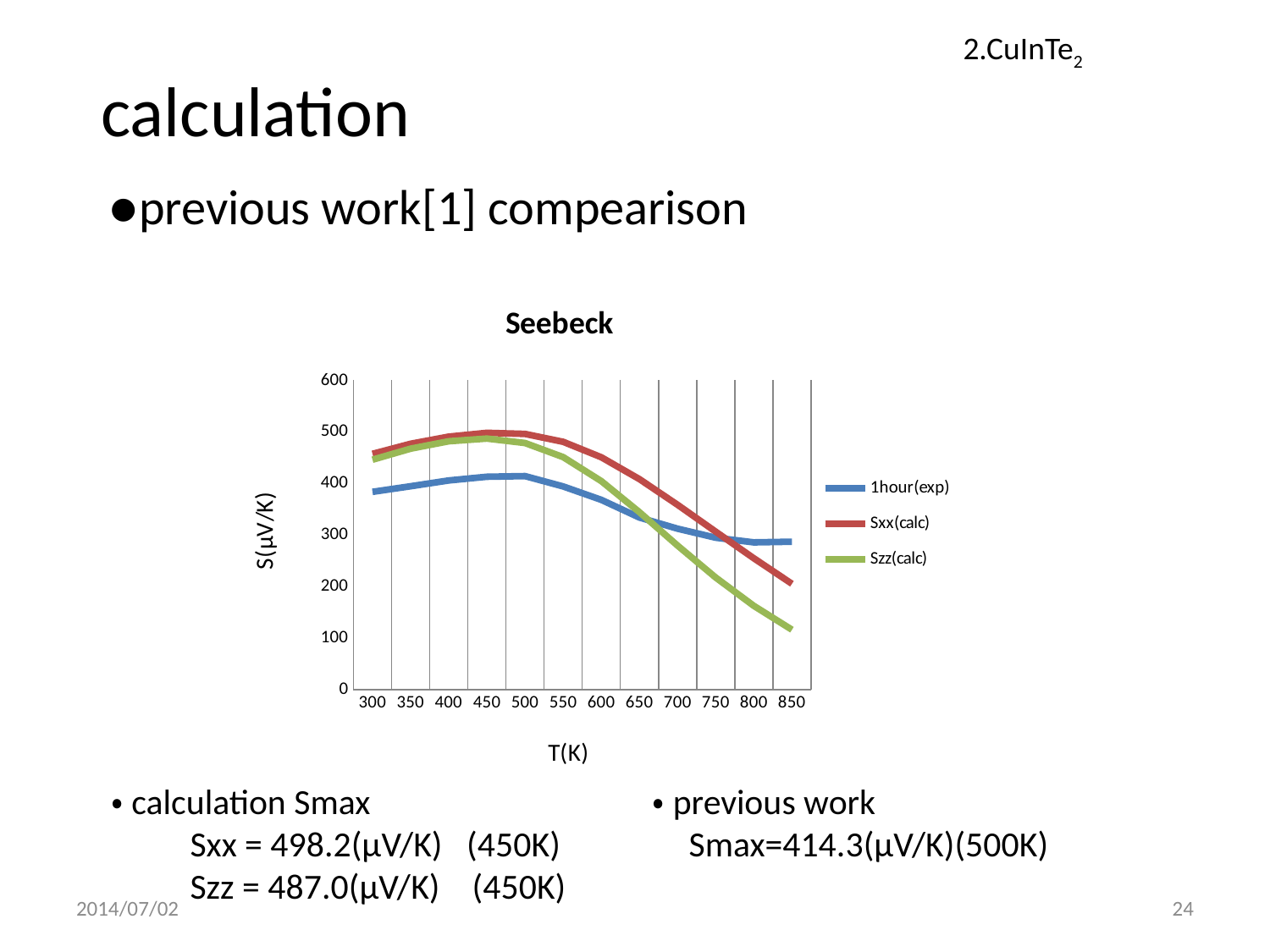
Is the value of 1hour(exp) at 300 K greater or less than 400? less Which series has the highest value at 850 K: Sxx(calc) or Szz(calc)? Sxx(calc) How many series does the legend of the Seebeck chart list? 3 At 300 K, which series is larger: 1hour(exp) or Sxx(calc)? Sxx(calc) Does the Szz(calc) series rise or fall between 500 K and 850 K? fall Is the value of Szz(calc) at 850 K greater or less than 200? less What kind of chart is shown on the slide? line chart Is the value of Sxx(calc) at 600 K greater or less than 400? greater What is the label of the y axis of the chart? S(μV/K) At 800 K, which series is larger: 1hour(exp) or Szz(calc)? 1hour(exp) According to the text on the slide, what is the maximum calculated Sxx value? 498.2(μV/K) What is the title of the chart? Seebeck